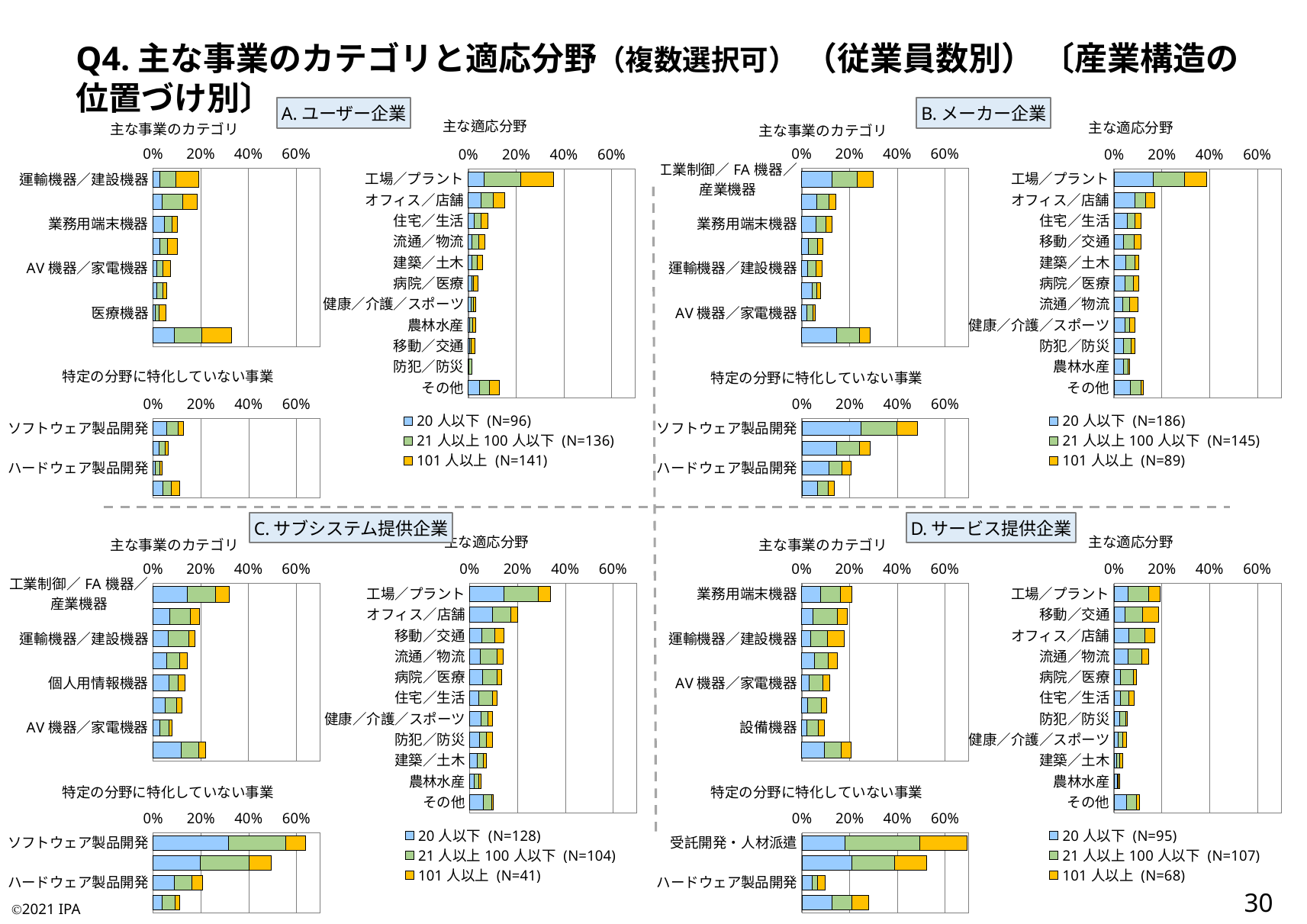
How many categories are shown in the 主な適応分野 chart in section D. サービス提供企業? 11 What kind of chart is the 主な適応分野 chart in section A. ユーザー企業? bar chart How many series does the legend list for the charts in section A. ユーザー企業? 3 How many categories are shown in the 主な適応分野 chart in section A. ユーザー企業? 11 In the 特定の分野に特化していない事業 chart in section C. サブシステム提供企業, is the total bar for ソフトウェア製品開発 greater or less than 40%? greater In the 主な適応分野 chart in section C. サブシステム提供企業, which bar is longer: 工場／プラント or 農林水産? 工場／プラント In section B. メーカー企業, what is the N value shown in the legend for 20 人以下? N=186 In the 主な適応分野 chart in section B. メーカー企業, is the total bar for 工場／プラント greater or less than 20%? greater In the 主な適応分野 chart in section A. ユーザー企業, which category has the longest bar? 工場／プラント In the 主な適応分野 chart in section D. サービス提供企業, which category has the shortest bar? 農林水産 In the 主な適応分野 chart in section A. ユーザー企業, which category has the shortest bar? 防犯／防災 In section C. サブシステム提供企業, what is the N value shown in the legend for 101 人以上? N=41